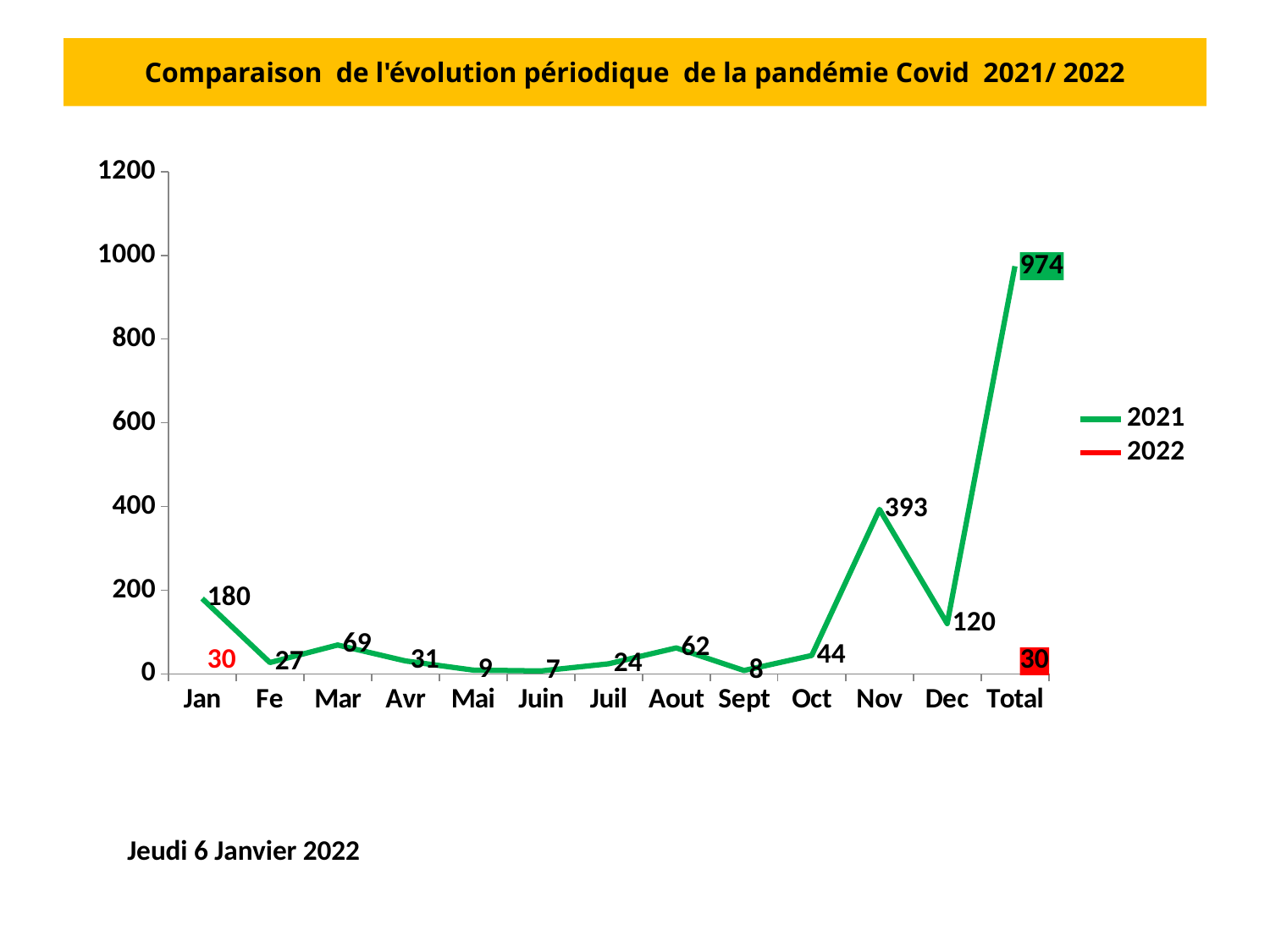
What is the difference between the 2021 values for Nov and Dec? 273 What is the 2022 value for Jan? 30 How many series does the legend list? 2 Which month has the lowest 2021 value? Juin What is the 2021 value for Nov? 393 Is the 2021 Total value greater or less than 1000? less What kind of chart is shown on the slide? line chart What colour is the 2022 series in the legend? red Which is larger, the 2021 value for Mar or the 2021 value for Aout? Mar What is the 2021 value for Jan? 180 What is the Total value for the 2021 series? 974 Excluding the Total category, which month has the highest 2021 value? Nov